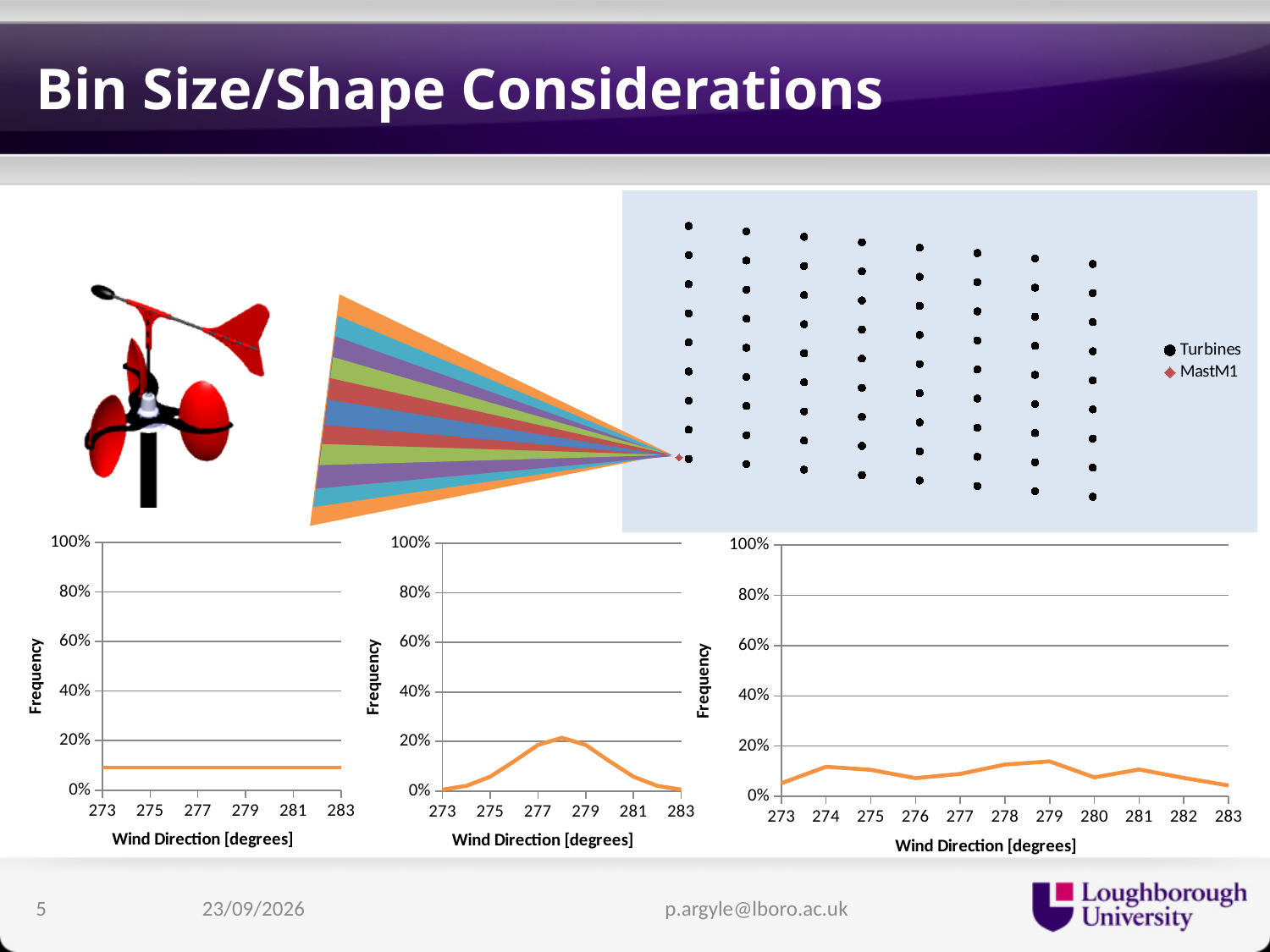
In the bottom-right chart, is the frequency at 279 degrees greater or less than 20%? less In the bottom-middle chart, is the frequency at 278 degrees greater or less than 20%? greater How many series does the legend of the top-right scatter chart list? 2 In the bottom-middle chart, which has the larger frequency, 278 degrees or 283 degrees? 278 degrees In the bottom-left chart, is the frequency at 277 degrees greater or less than 20%? less What kind of chart is the bottom-left chart? line chart In the bottom-middle chart, does the frequency rise or fall from 273 to 278 degrees? rise In the bottom-middle chart, at which wind direction is the frequency highest? 278 In the bottom-right chart, at which wind direction is the frequency lowest? 283 What is the y-axis title of the bottom-left chart? Frequency How many wind direction labels are shown on the x axis of the bottom-right chart? 11